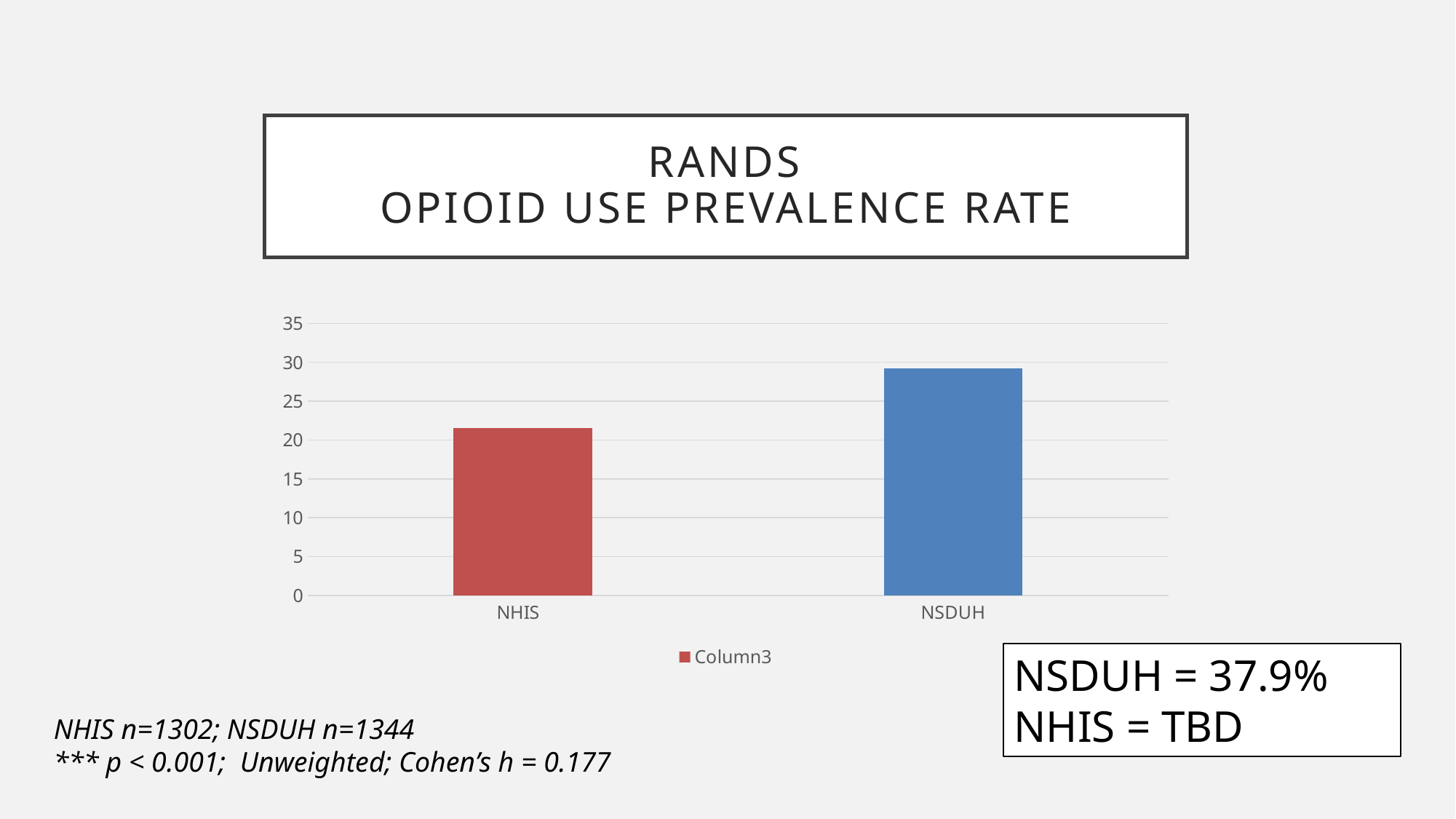
How many series does the chart legend list? 1 Which category has the highest bar in the chart? NSDUH Which bar is taller, NHIS or NSDUH? NSDUH What type of chart is shown on the slide? bar chart How many categories are shown on the x axis of the chart? 2 Is the value for NSDUH greater or less than 25? greater Is the value for NSDUH greater or less than 35? less What is the name of the series shown in the chart legend? Column3 Which category has the lowest bar in the chart? NHIS Is the value for NHIS greater or less than 25? less What is the title of the chart on the slide? RANDS OPIOID USE PREVALENCE RATE